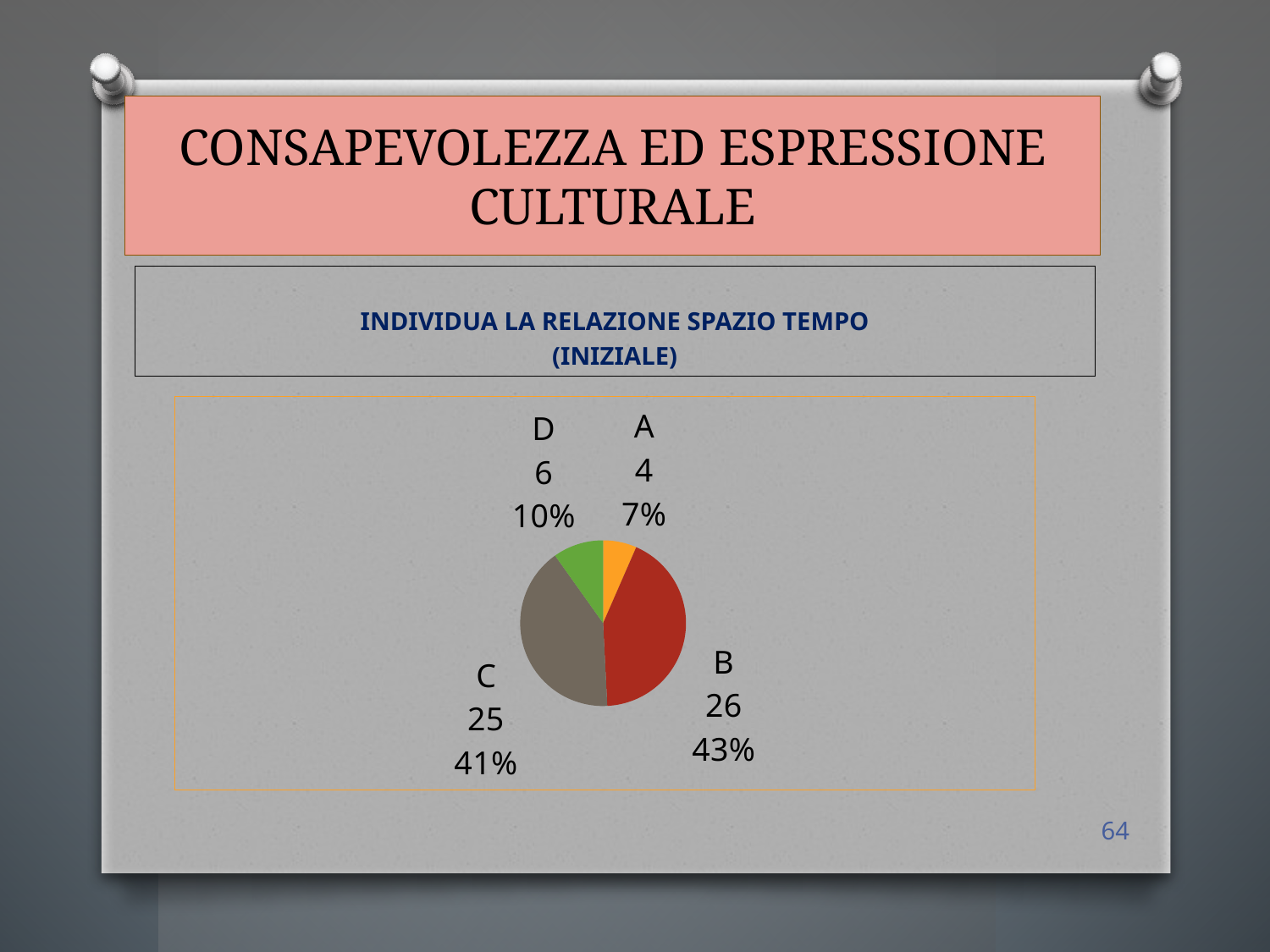
What is the value for category B? 26 What kind of chart is shown on the slide? pie chart What is the difference between the values for B and A? 22 What is the value for category D? 6 What percentage share does category B have? 43% Which category has the smallest slice? A What percentage share does category D have? 10% How many categories does the pie chart have? 4 Which category has the largest slice? B What is the value for category C? 25 Which is larger, the value for D or the value for A? D What is the value for category A? 4